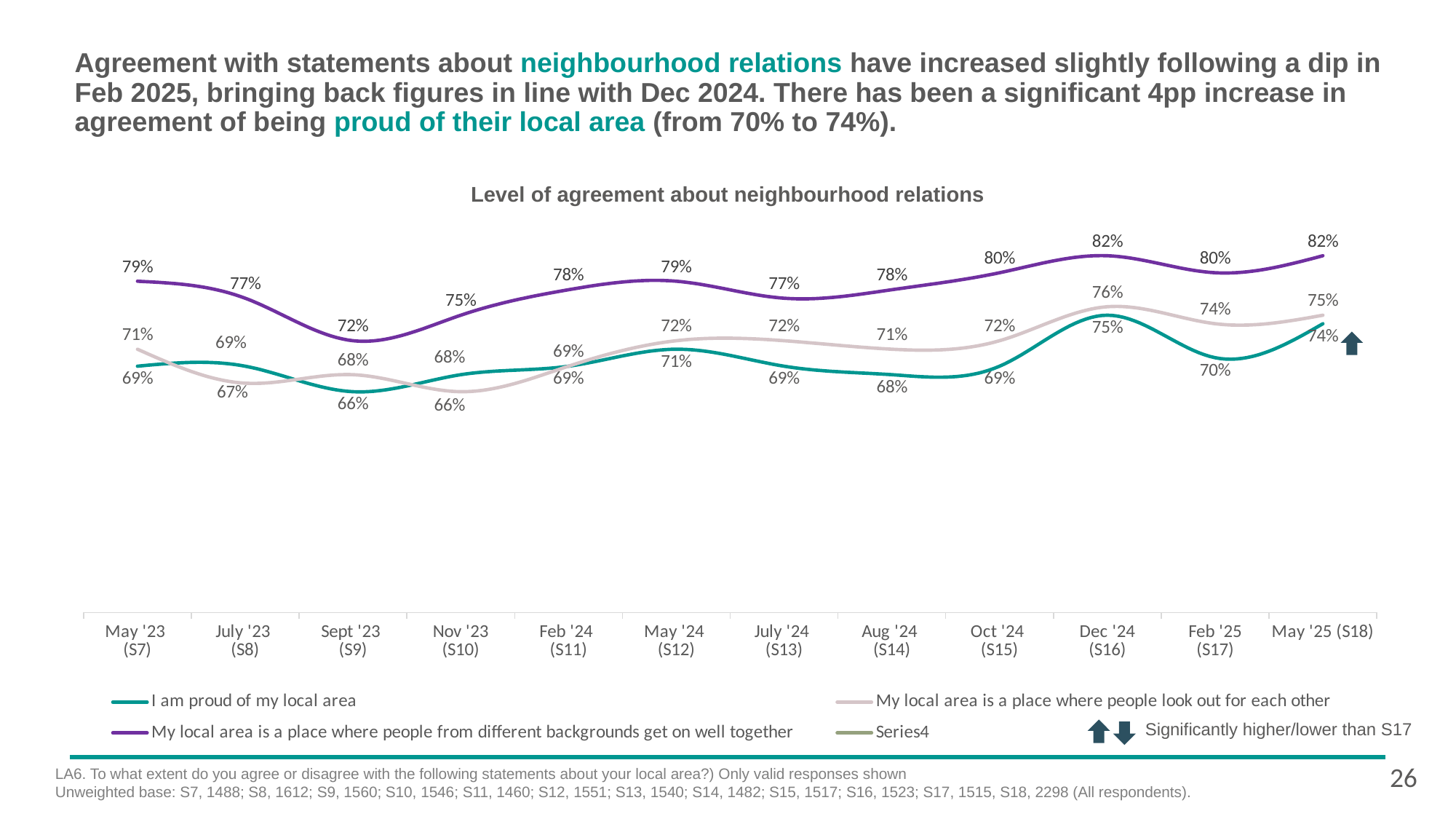
By how many percentage points did 'I am proud of my local area' change from Feb '25 (S17) to May '25 (S18)? 4 percentage points What kind of chart is shown on the slide? Line chart What is the value for 'My local area is a place where people look out for each other' in Nov '23 (S10)? 66% In Feb '25 (S17), which is higher: 'I am proud of my local area' or 'My local area is a place where people look out for each other'? My local area is a place where people look out for each other What is the title of the chart? Level of agreement about neighbourhood relations How many entries does the legend list? 4 What is the value for 'I am proud of my local area' in Feb '25 (S17)? 70% What is the value for 'My local area is a place where people from different backgrounds get on well together' in Dec '24 (S16)? 82% How many survey waves (points) are plotted along the x axis? 12 In which wave is 'I am proud of my local area' at its lowest? Sept '23 (S9) In which wave is 'My local area is a place where people from different backgrounds get on well together' at its lowest? Sept '23 (S9) What is the difference between the May '23 (S7) and Sept '23 (S9) values for 'My local area is a place where people from different backgrounds get on well together'? 7 percentage points